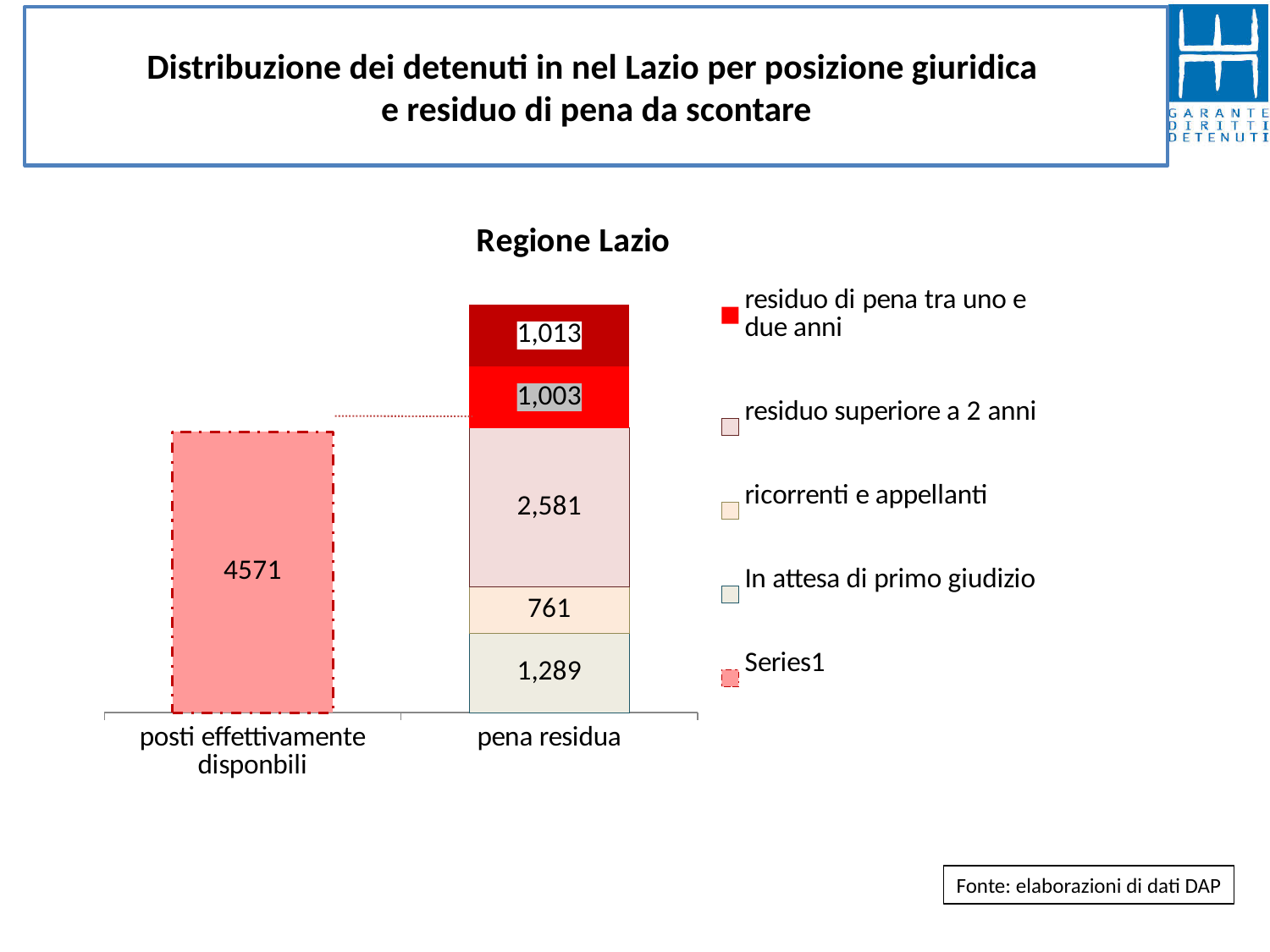
In the 'pena residua' bar, what is the value of the 'In attesa di primo giudizio' segment? 1,289 What is the total of the stacked 'pena residua' bar? 6,647 What is the difference between the 'residuo superiore a 2 anni' segment and the 'ricorrenti e appellanti' segment? 1,820 What is the title of the chart? Regione Lazio Which segment of the 'pena residua' bar is the largest? residuo superiore a 2 anni What kind of chart is shown on the slide? Stacked bar chart How many categories are shown on the x axis? 2 What is the value for 'posti effettivamente disponbili'? 4571 In the 'pena residua' bar, what is the value of the 'residuo superiore a 2 anni' segment? 2,581 How many entries does the legend list? 5 In the 'pena residua' bar, what is the value of the 'ricorrenti e appellanti' segment? 761 What is the value of the topmost segment of the 'pena residua' bar? 1,013